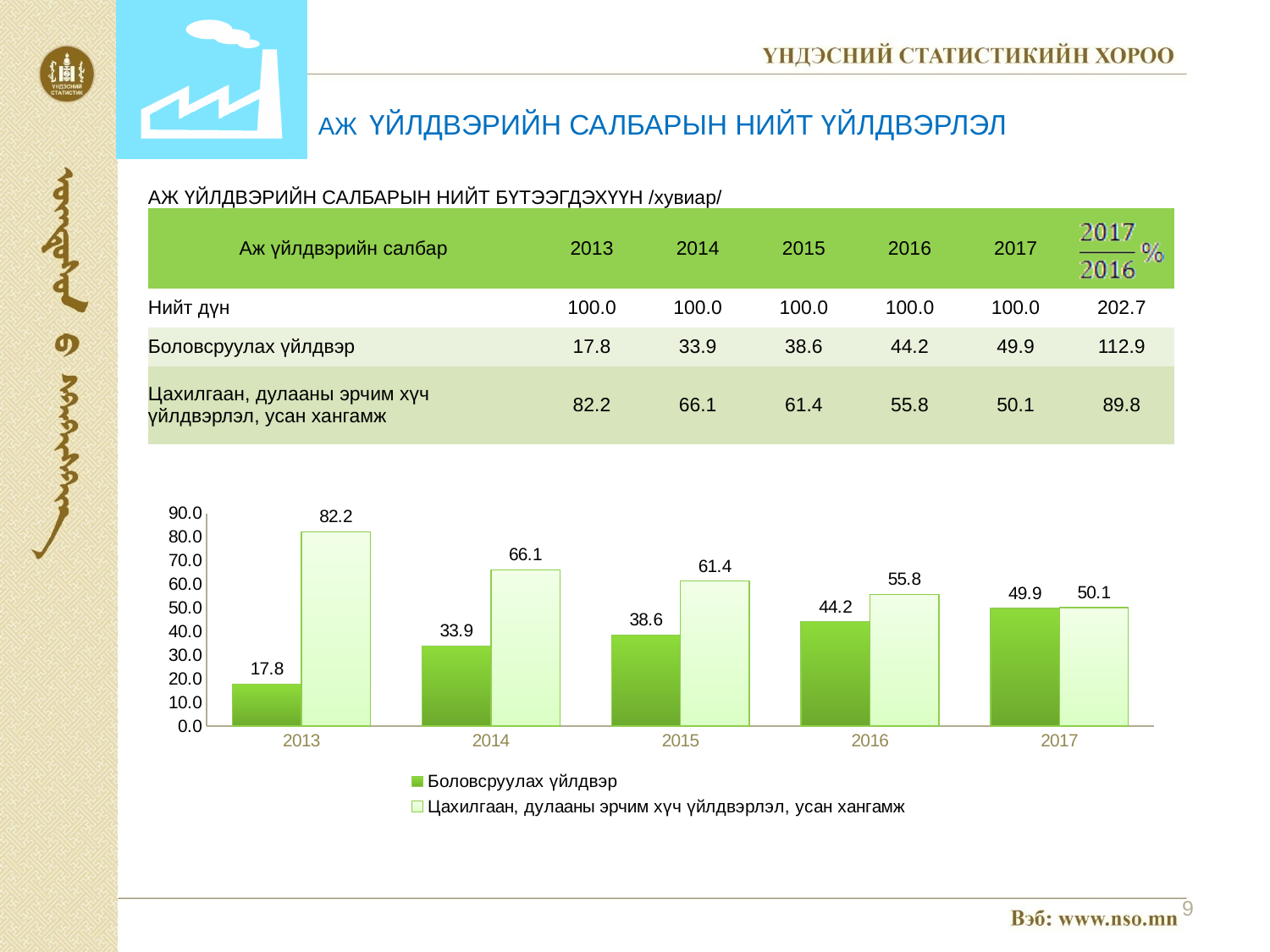
Does the value for Боловсруулах үйлдвэр rise or fall from 2013 to 2017? rise How many years are shown on the x axis of the chart? 5 What is the value for Цахилгаан, дулааны эрчим хүч үйлдвэрлэл, усан хангамж in 2015? 61.4 What is the value for Боловсруулах үйлдвэр in 2013? 17.8 In 2016, which series has the larger value? Цахилгаан, дулааны эрчим хүч үйлдвэрлэл, усан хангамж What kind of chart is shown on the slide? bar chart What is the value for Боловсруулах үйлдвэр in 2017? 49.9 In which year is the value for Боловсруулах үйлдвэр lowest? 2013 Is the value for Боловсруулах үйлдвэр in 2015 greater or less than 40.0? less What is the difference between the two series' values in 2014? 32.2 How many series does the chart legend list? 2 In which year is the value for Цахилгаан, дулааны эрчим хүч үйлдвэрлэл, усан хангамж highest? 2013